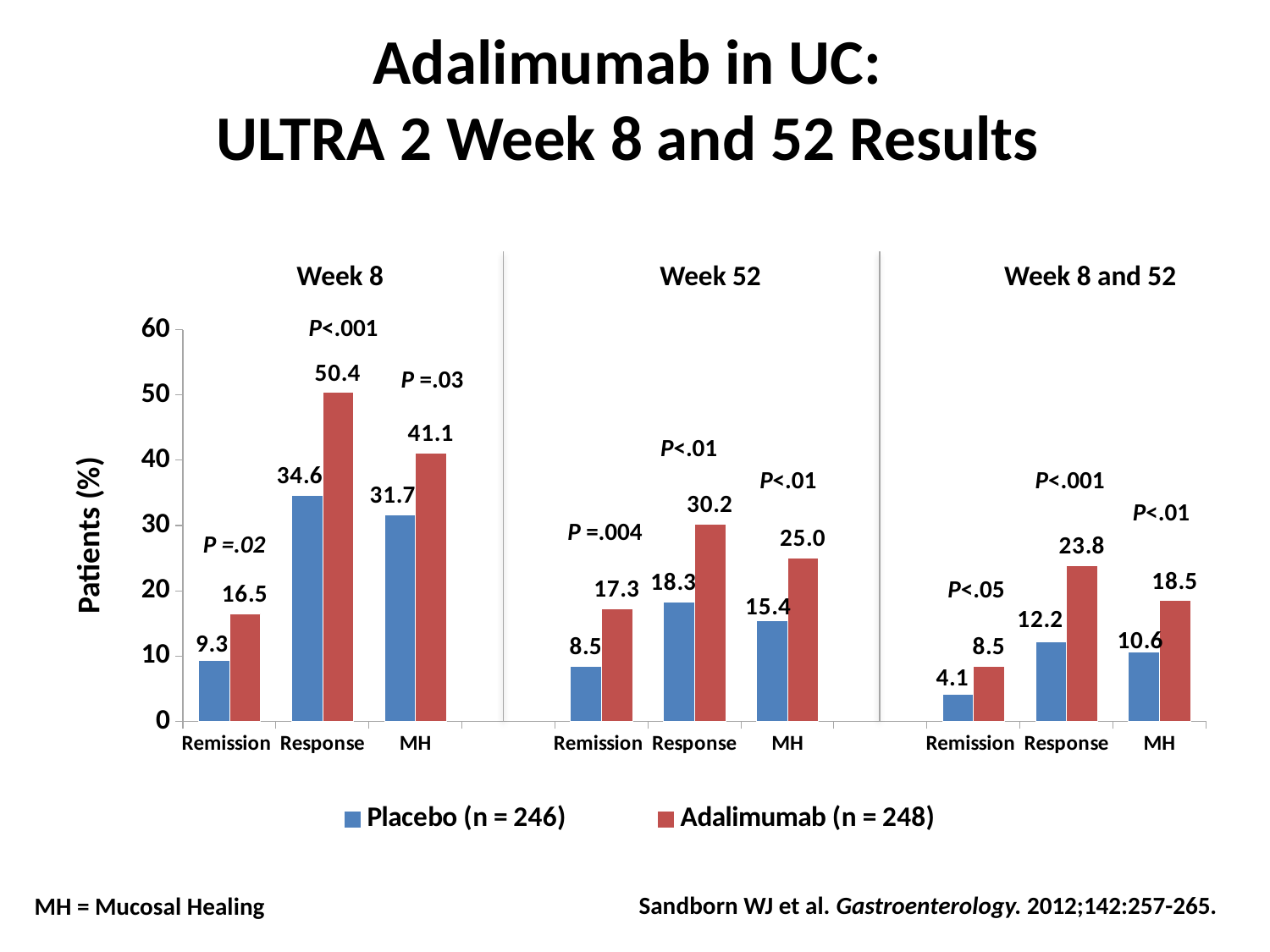
Which is larger at Week 52: the Placebo value for Response or the Adalimumab value for Remission? Placebo value for Response Is the Placebo value for MH at Week 8 greater or less than 30? greater Which category and week has the highest Adalimumab value on the chart? Response at Week 8 Which category and week has the lowest Placebo value on the chart? Remission at Week 8 and 52 What is the label of the y axis? Patients (%) How many series does the legend list? 2 What is the difference between the Adalimumab and Placebo values for Response at Week 8? 15.8 What is the Placebo value for Remission at Week 52? 8.5 What is the difference between the Adalimumab and Placebo values for MH at Week 52? 9.6 What is the Adalimumab value for Response at Week 8? 50.4 What kind of chart is shown on the slide? Bar chart What is the Adalimumab value for MH at Week 8 and 52? 18.5